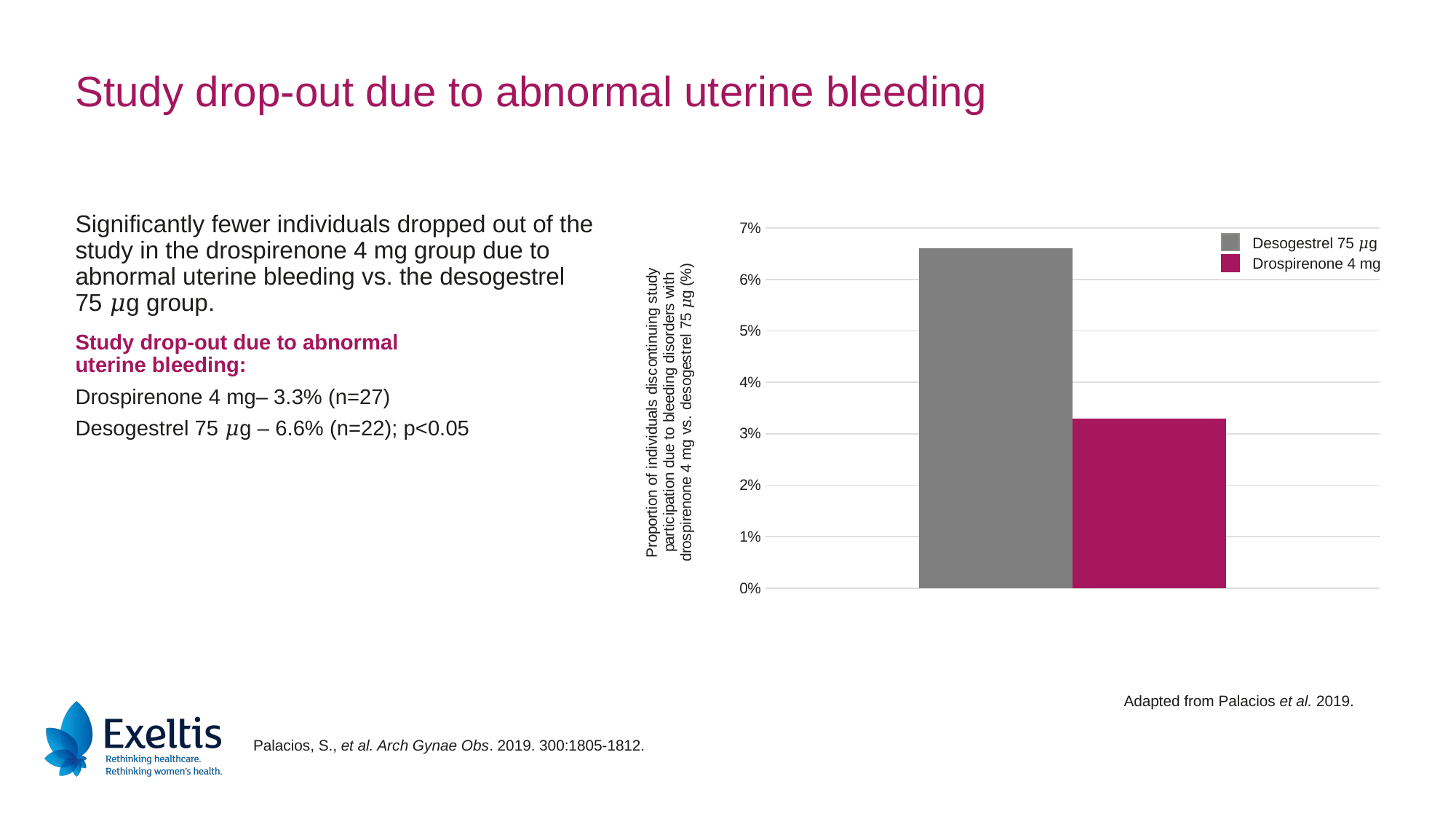
What kind of chart is shown on the slide? Bar chart Is the drop-out proportion for Drospirenone 4 mg greater or less than 4%? less Which group has the higher study drop-out proportion due to abnormal uterine bleeding? Desogestrel 75 µg What is the difference in drop-out proportion between the Desogestrel 75 µg group and the Drospirenone 4 mg group? 3.3% What is the study drop-out proportion due to abnormal uterine bleeding for the Desogestrel 75 µg group? 6.6% How many series does the chart legend list? 2 Which colour represents Drospirenone 4 mg in the chart legend? Magenta Is the drop-out proportion for Desogestrel 75 µg greater or less than 6%? greater What is the study drop-out proportion due to abnormal uterine bleeding for the Drospirenone 4 mg group? 3.3% How many bars are plotted in the chart? 2 Is the drop-out proportion for Drospirenone 4 mg greater or less than 3%? greater Which group has the lower study drop-out proportion due to abnormal uterine bleeding? Drospirenone 4 mg